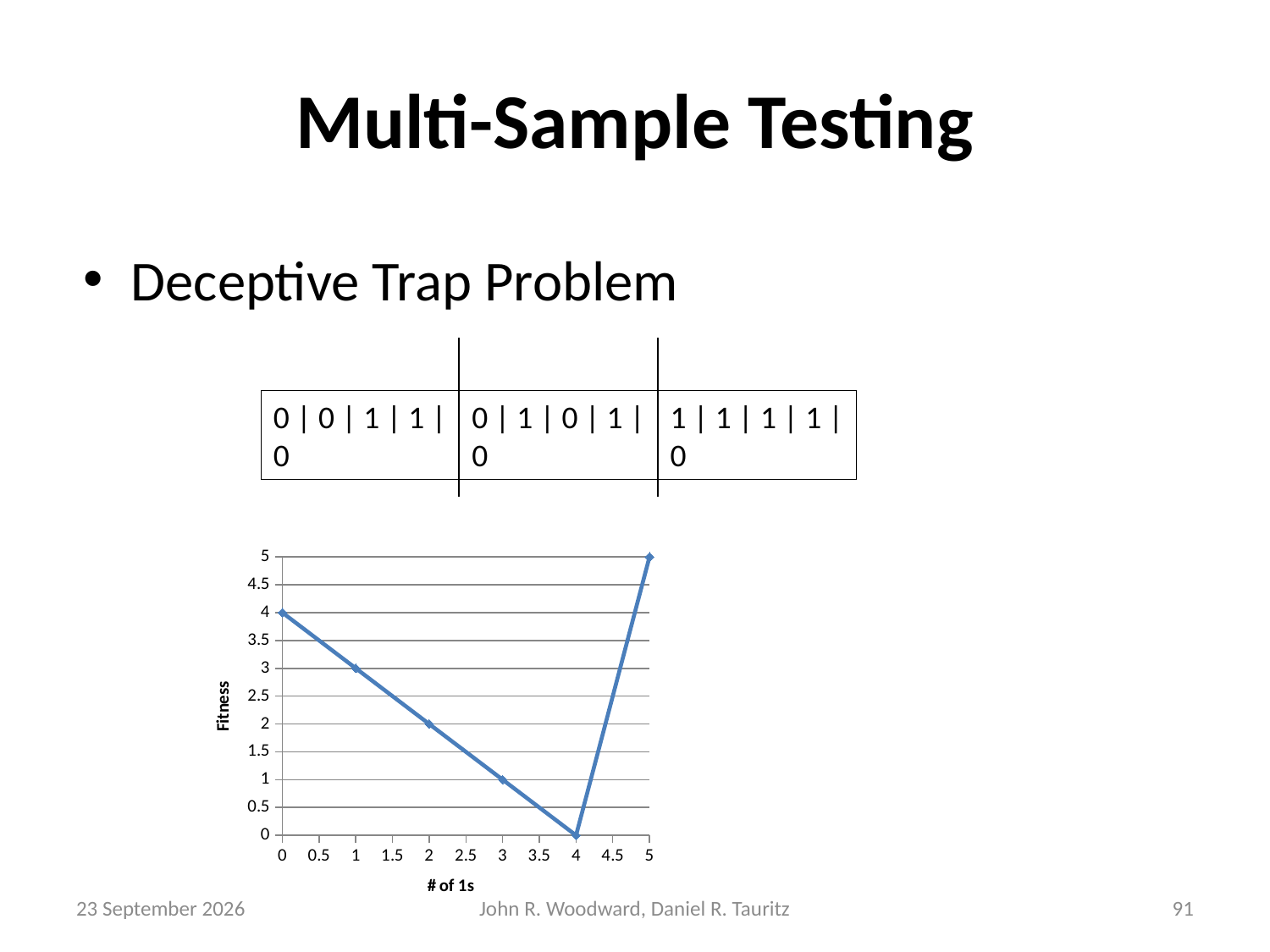
What is the fitness value when the number of 1s is 0? 4 What kind of chart is shown on the slide? Line chart At which number of 1s is the fitness highest? 5 At which number of 1s is the fitness lowest? 4 What is the fitness value when the number of 1s is 5? 5 What is the label of the vertical axis of the chart? Fitness What is the difference in fitness between 5 ones and 4 ones? 5 How many data points are plotted on the chart? 6 What is the fitness value when the number of 1s is 4? 0 Which has the higher fitness: 1 one or 3 ones? 1 one What is the fitness value when the number of 1s is 2? 2 How does fitness change as the number of 1s increases from 0 to 4? It falls